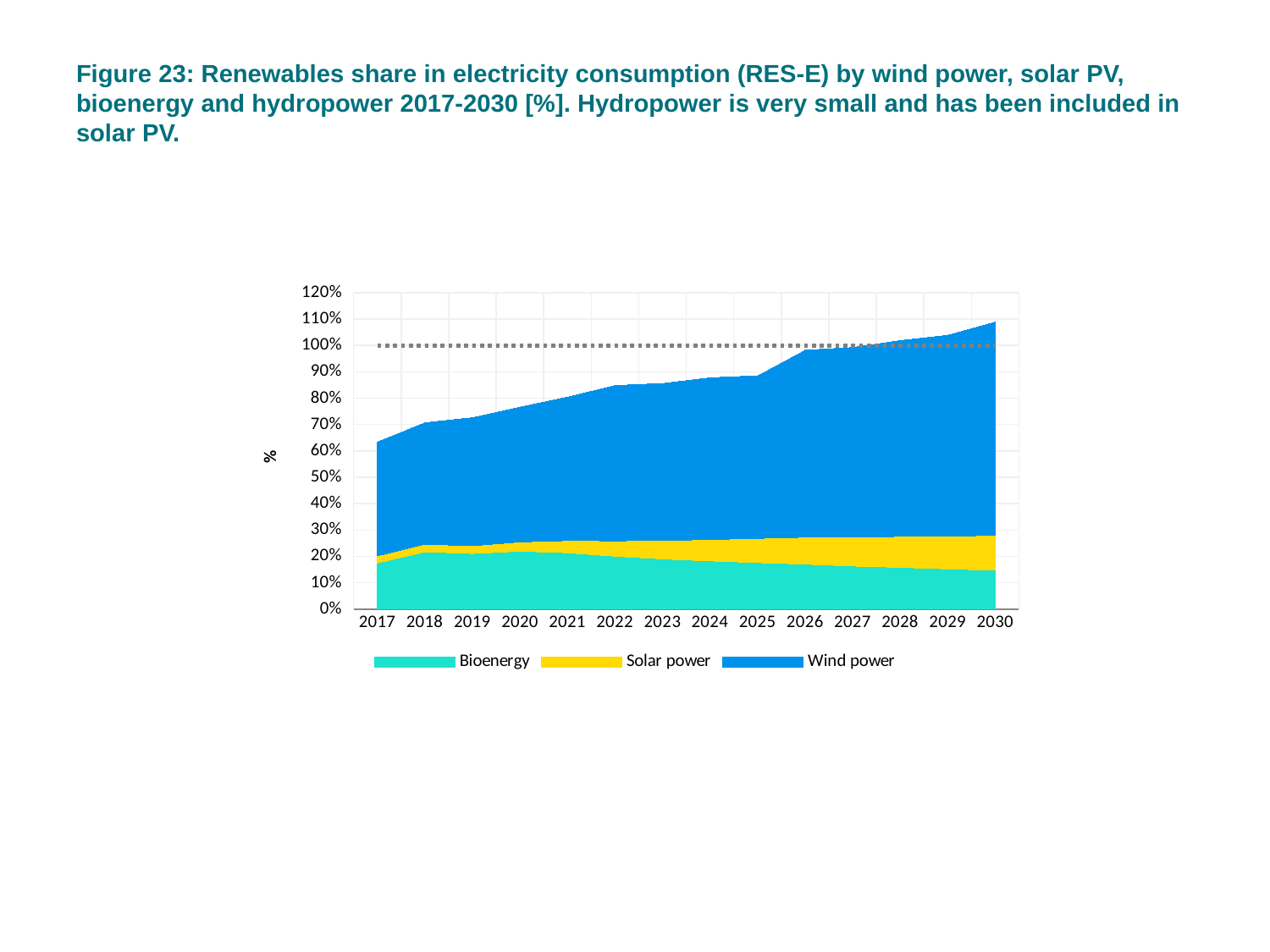
Which series has the smallest share in 2017? Solar power Does the Solar power share rise or fall between 2020 and 2030? Rise Which series occupies the largest share of the stacked area across all years? Wind power How many years are plotted along the x axis? 14 What kind of chart is shown on the slide? Stacked area chart Is the total renewables share in 2030 greater or less than 100%? greater Does the total renewables share rise or fall from 2017 to 2030? Rise Is the total renewables share in 2017 greater or less than 70%? less How many series does the legend list? 3 Is the Bioenergy share in 2030 greater or less than 20%? less At what level is the horizontal dotted reference line drawn? 100%